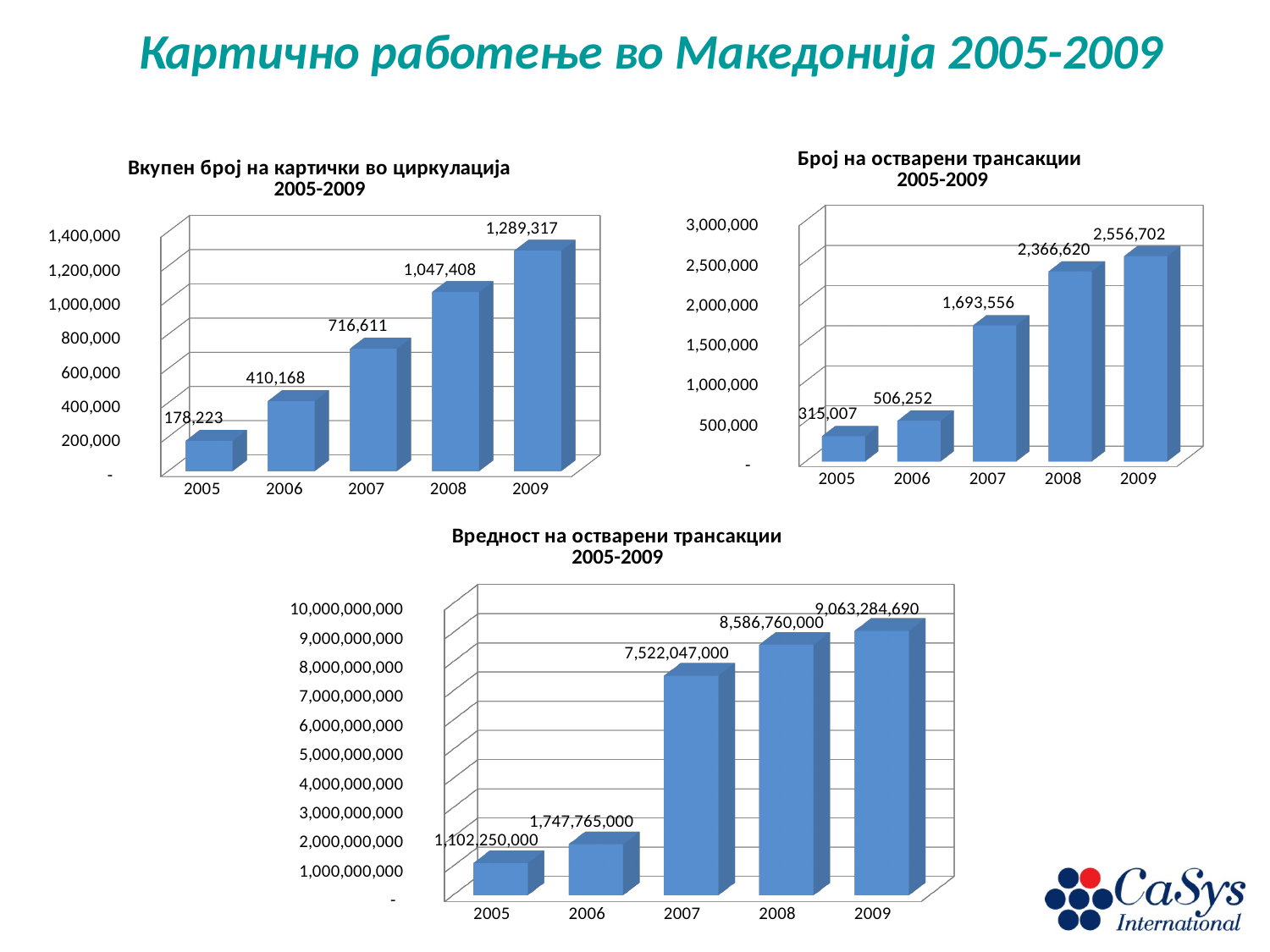
How many years are shown on the x axis of the chart titled 'Број на остварени трансакции 2005-2009'? 5 In the chart titled 'Вредност на остварени трансакции 2005-2009', what is the difference between the 2008 and 2007 values? 1,064,713,000 In the chart titled 'Вкупен број на картички во циркулација 2005-2009', what is the value for 2007? 716,611 In the chart titled 'Вредност на остварени трансакции 2005-2009', do the values rise or fall from 2005 to 2009? rise In the chart titled 'Број на остварени трансакции 2005-2009', what is the value for 2008? 2,366,620 In the chart titled 'Број на остварени трансакции 2005-2009', which year has the highest value? 2009 In the chart titled 'Вредност на остварени трансакции 2005-2009', is the value for 2006 larger or smaller than the value for 2007? smaller What kind of chart is the chart titled 'Вкупен број на картички во циркулација 2005-2009'? bar chart In the chart titled 'Број на остварени трансакции 2005-2009', what is the difference between the 2007 and 2006 values? 1,187,304 In the chart titled 'Вкупен број на картички во циркулација 2005-2009', what is the difference between the 2009 and 2008 values? 241,909 In the chart titled 'Вредност на остварени трансакции 2005-2009', what is the value for 2005? 1,102,250,000 In the chart titled 'Вкупен број на картички во циркулација 2005-2009', which year has the lowest value? 2005